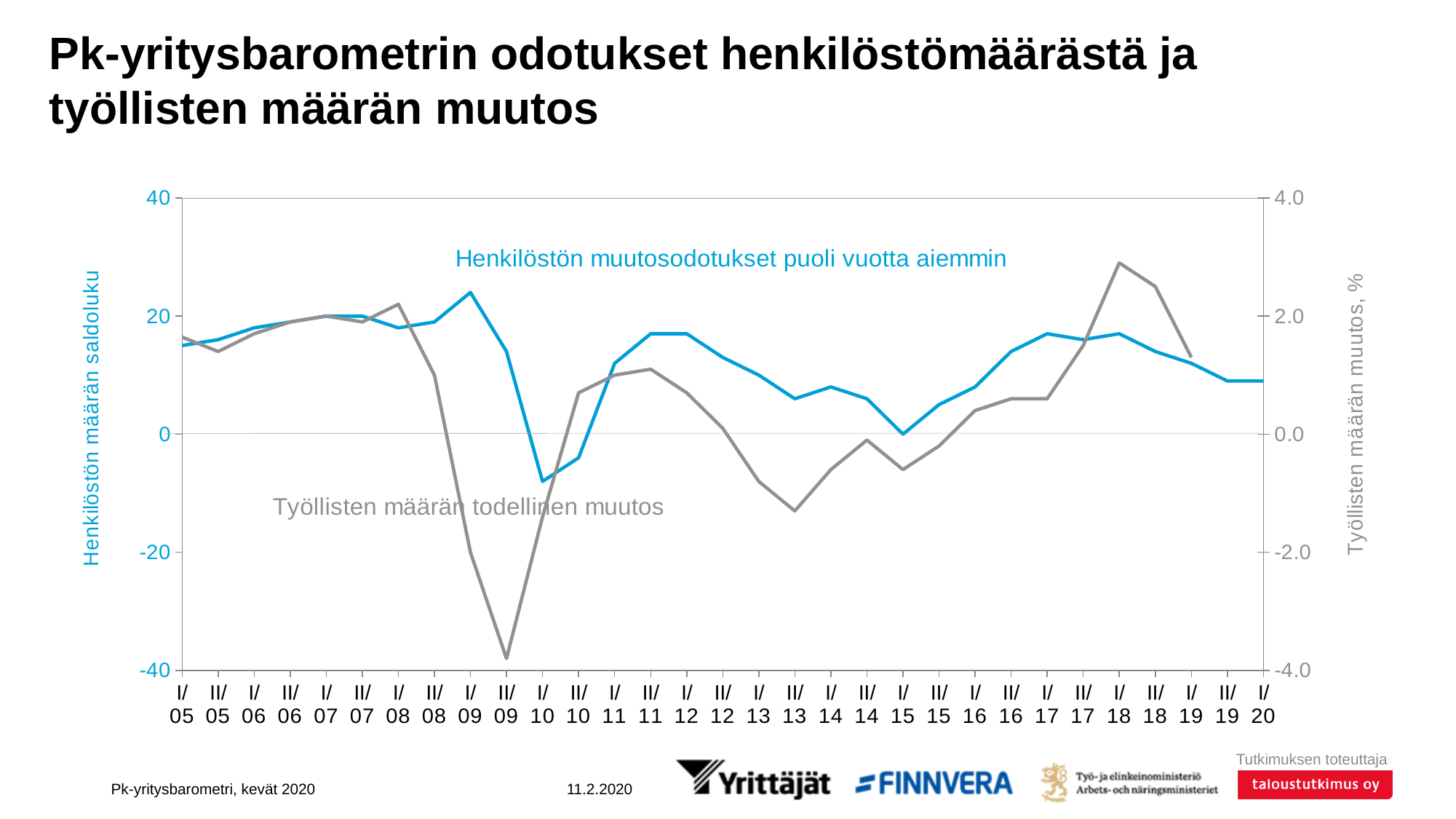
How many data series are plotted in the chart? 2 Does the 'Henkilöstön muutosodotukset puoli vuotta aiemmin' line rise or fall from I/18 to I/20? fall What kind of chart is shown on the slide? line chart At which time point does the 'Työllisten määrän todellinen muutos' line reach its highest value? I/18 Is the value of 'Henkilöstön muutosodotukset puoli vuotta aiemmin' at I/20 greater or less than 20? less At which time point does the 'Henkilöstön muutosodotukset puoli vuotta aiemmin' line reach its highest value? I/09 At which time point does the 'Työllisten määrän todellinen muutos' line reach its lowest value? II/09 What is the label of the right-hand vertical axis? Työllisten määrän muutos, % Is the value of 'Henkilöstön muutosodotukset puoli vuotta aiemmin' at I/10 greater or less than 0? less Is the value of 'Työllisten määrän todellinen muutos' at II/09 greater or less than -2.0? less How many time points are shown on the x axis of the chart? 31